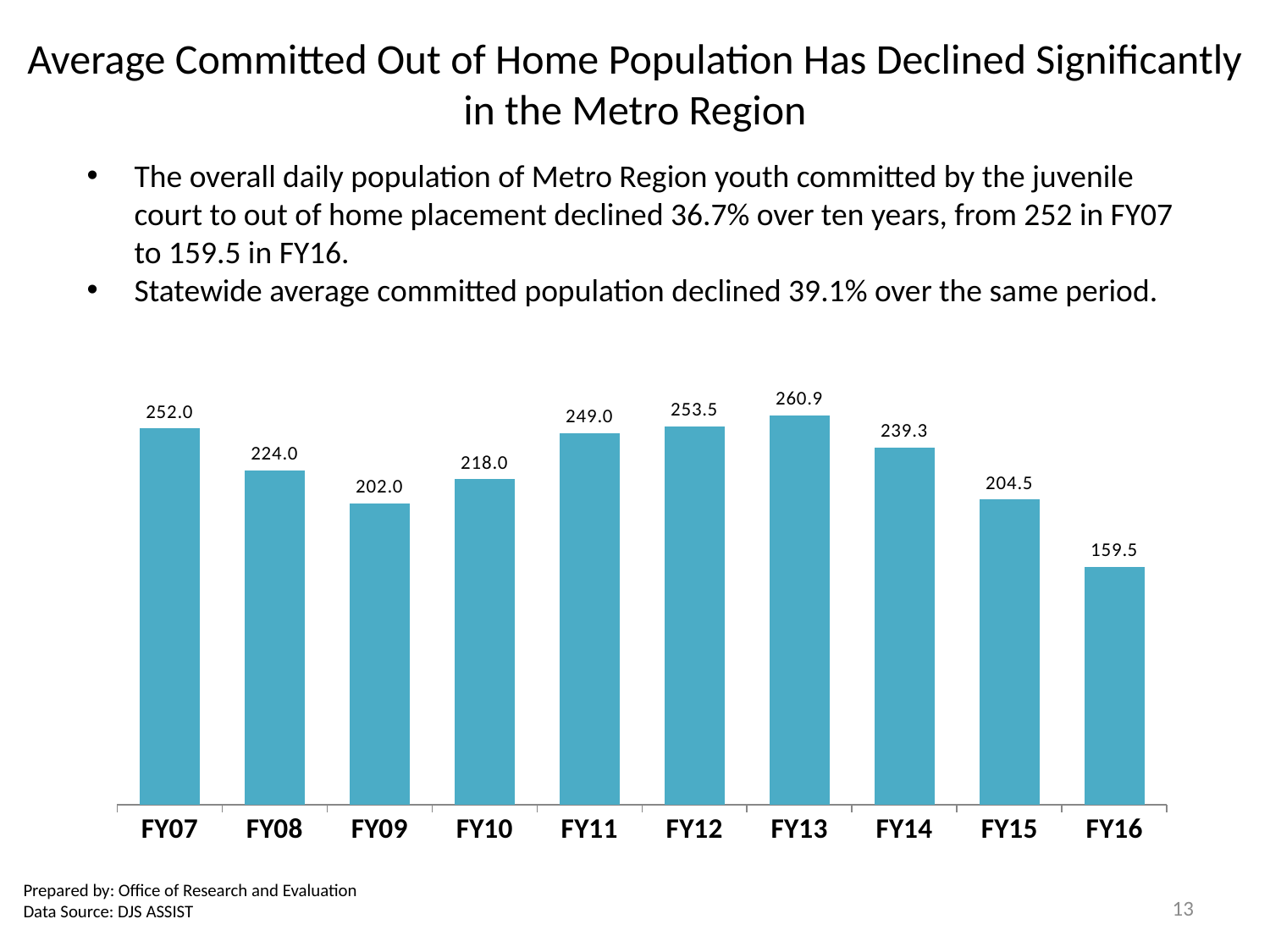
What is the difference between the values for FY13 and FY14? 21.6 How many fiscal years are shown on the x axis? 10 Which fiscal year has the highest value? FY13 What kind of chart is shown on the slide? bar chart Which fiscal year has the lowest value? FY16 Do the values rise or fall from FY13 to FY16? fall Which is larger, the value for FY09 or the value for FY10? FY10 What is the value for FY13? 260.9 Which is larger, the value for FY12 or the value for FY11? FY12 What is the difference between the values for FY07 and FY16? 92.5 What is the value for FY16? 159.5 What is the value for FY07? 252.0